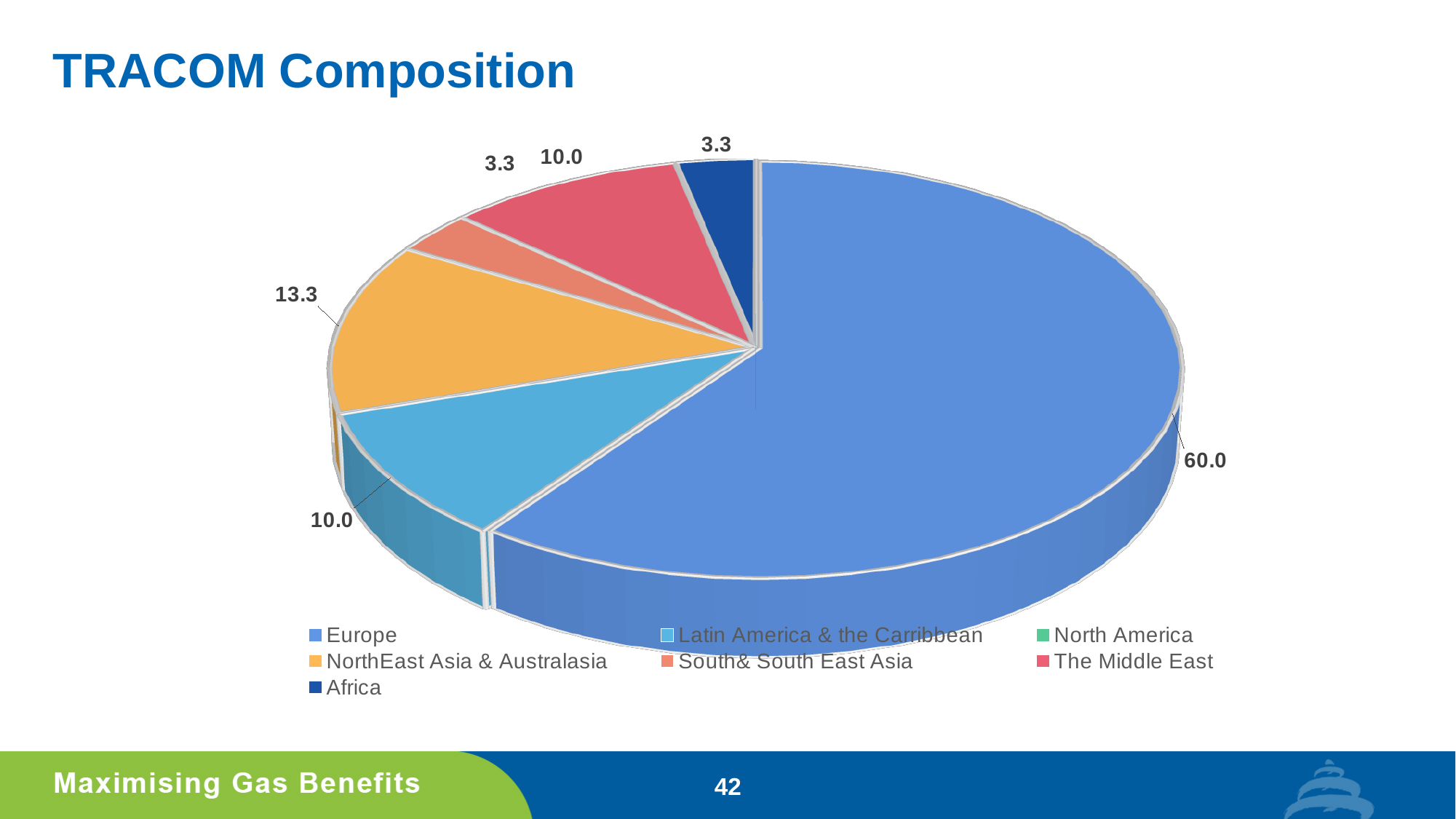
What is the value shown for The Middle East? 10.0 What is the value shown for Africa? 3.3 Which region has the largest slice of the pie chart? Europe What kind of chart is shown on the slide? Pie chart What is the value shown for South& South East Asia? 3.3 What is the difference between the value for Europe and the value for NorthEast Asia & Australasia? 46.7 Which is larger, the value for NorthEast Asia & Australasia or the value for The Middle East? NorthEast Asia & Australasia What is the title of the slide containing the chart? TRACOM Composition What is the value shown for Latin America & the Carribbean? 10.0 How many entries does the legend list? 7 What is the value shown for NorthEast Asia & Australasia? 13.3 What is the value shown for Europe in the pie chart? 60.0